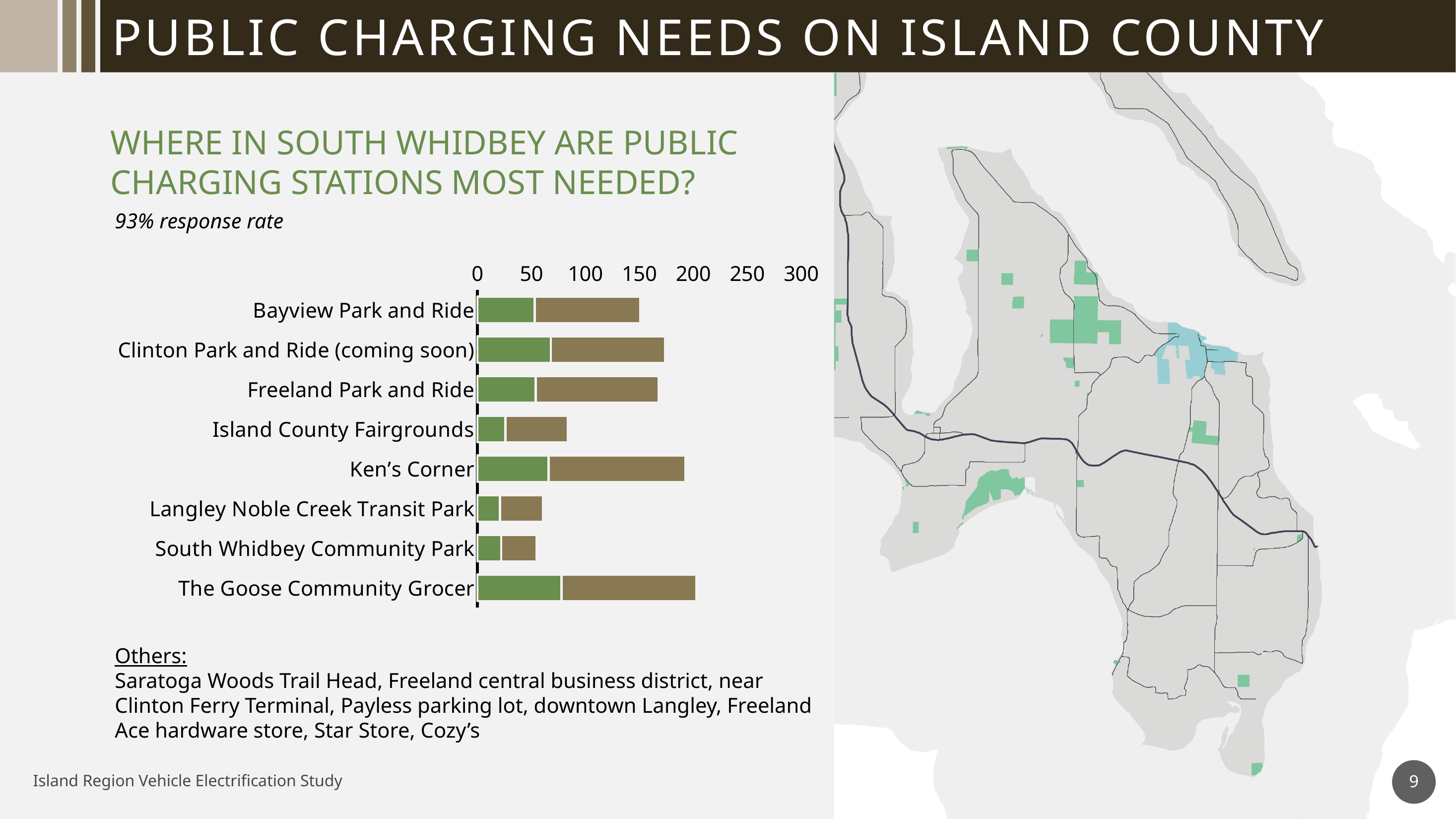
Is the total bar length for The Goose Community Grocer greater or less than 150? greater Is the total bar length for South Whidbey Community Park greater or less than 100? less Which has the longer total bar, Bayview Park and Ride or Langley Noble Creek Transit Park? Bayview Park and Ride Is the total bar length for Bayview Park and Ride greater or less than 100? greater What response rate is stated above the chart? 93% response rate Which has the longer total bar, Ken's Corner or Island County Fairgrounds? Ken's Corner How many locations are listed as categories in the chart? 8 What is the highest value shown on the chart's horizontal axis? 300 What kind of chart is shown on the slide? bar chart